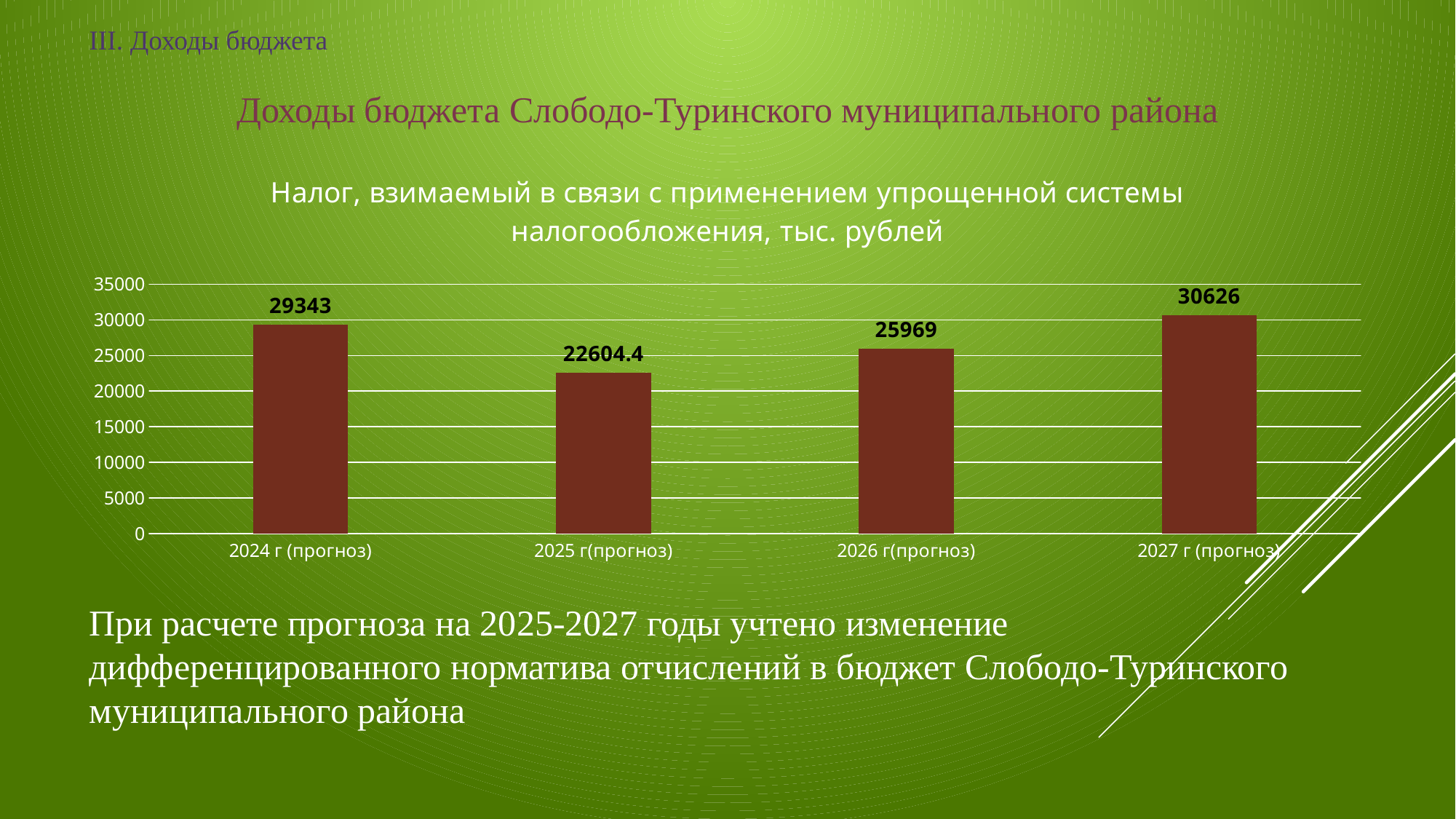
What is the difference between the values for 2027 г (прогноз) and 2024 г (прогноз)? 1283 Which is larger, the value for 2024 г (прогноз) or the value for 2026 г(прогноз)? 2024 г (прогноз) What kind of chart is shown on the slide? bar chart What is the value for 2025 г(прогноз)? 22604.4 Do the values rise or fall from 2025 г(прогноз) to 2027 г (прогноз)? rise What is the difference between the values for 2026 г(прогноз) and 2025 г(прогноз)? 3364.6 What is the value for 2026 г(прогноз)? 25969 Which year has the highest value? 2027 г (прогноз) How many years are shown on the chart? 4 Which year has the lowest value? 2025 г(прогноз) What is the value for 2024 г (прогноз)? 29343 What is the value for 2027 г (прогноз)? 30626